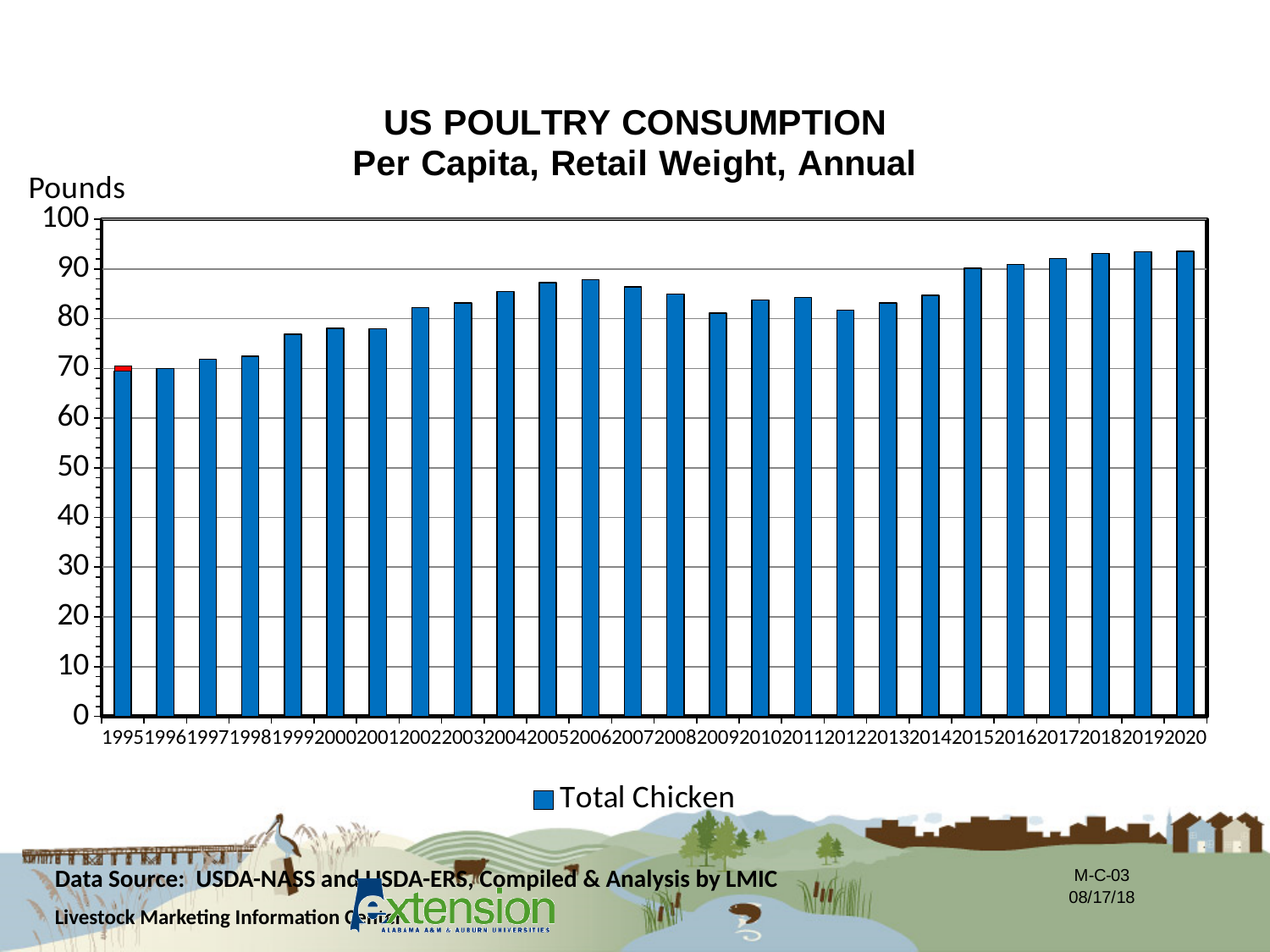
Overall, do the values rise or fall from 1995 to 2020? rise Is the value for 2006 greater or less than 90? less Which year has the larger value, 2012 or 2015? 2015 Is the value for 2020 greater or less than 90? greater What is the name of the series shown in the legend? Total Chicken What kind of chart is shown on the slide? bar chart What unit is shown on the y axis of the chart? Pounds How many years are plotted along the x axis of the chart? 26 Is the value for 1996 greater or less than 80? less Which year has the larger value, 2005 or 2009? 2005 How many series does the legend list? 1